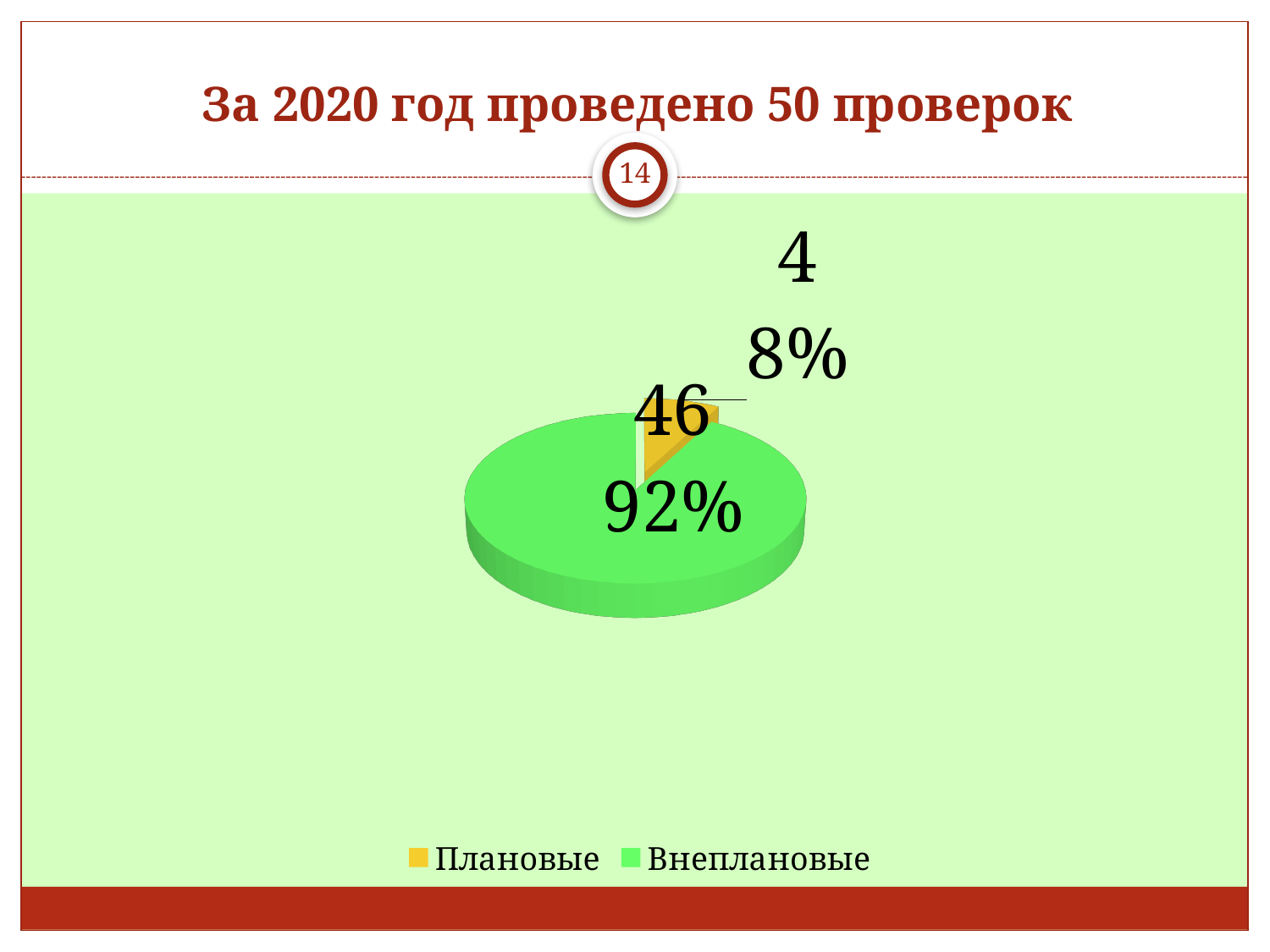
What is the value for Внеплановые? 46 What kind of chart is shown on the slide? pie chart Which is larger, Плановые or Внеплановые? Внеплановые What is the difference between the values for Внеплановые and Плановые? 42 Which category is the smallest? Плановые What colour is the Плановые slice? yellow How many slices does the pie chart have? 2 What share of the pie does Внеплановые represent? 92% How many entries does the legend list? 2 What share of the pie does Плановые represent? 8% What is the value for Плановые? 4 Which category is the largest? Внеплановые